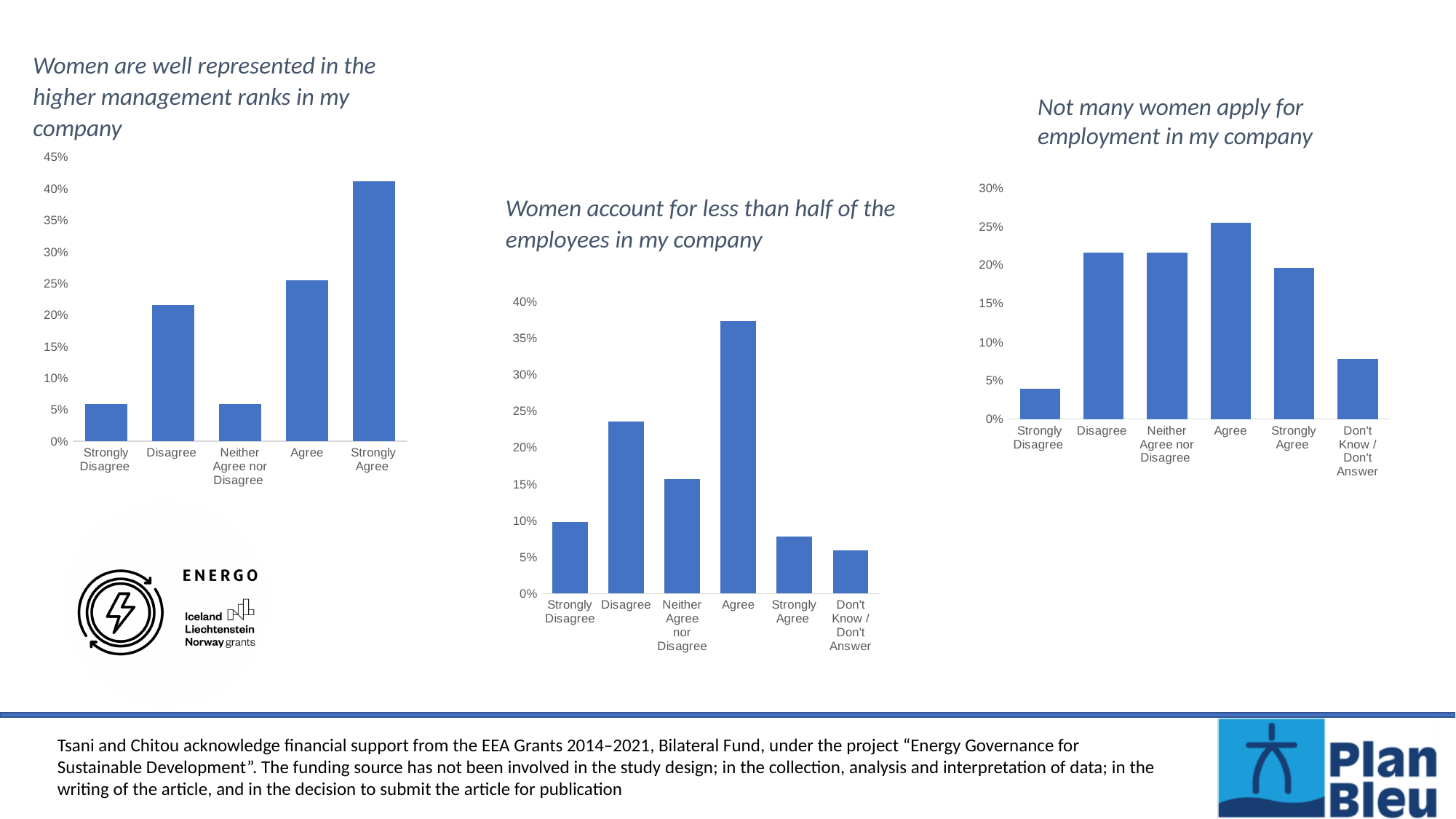
How many categories are shown in the chart titled "Women account for less than half of the employees in my company"? 6 In the chart titled "Women account for less than half of the employees in my company", which category has the highest value? Agree What type of chart is the chart titled "Not many women apply for employment in my company"? bar chart In the chart titled "Women are well represented in the higher management ranks in my company", which is larger, Agree or Disagree? Agree In the chart titled "Women account for less than half of the employees in my company", which is larger, Disagree or Neither Agree nor Disagree? Disagree In the chart titled "Not many women apply for employment in my company", is the value for Don't Know / Don't Answer greater or less than 10%? less In the chart titled "Not many women apply for employment in my company", which category has the highest value? Agree How many categories are shown in the chart titled "Women are well represented in the higher management ranks in my company"? 5 In the chart titled "Not many women apply for employment in my company", which category has the lowest value? Strongly Disagree In the chart titled "Women are well represented in the higher management ranks in my company", is the value for Strongly Agree greater or less than 35%? greater In the chart titled "Women are well represented in the higher management ranks in my company", which category has the highest value? Strongly Agree In the chart titled "Women account for less than half of the employees in my company", is the value for Strongly Disagree greater or less than 15%? less